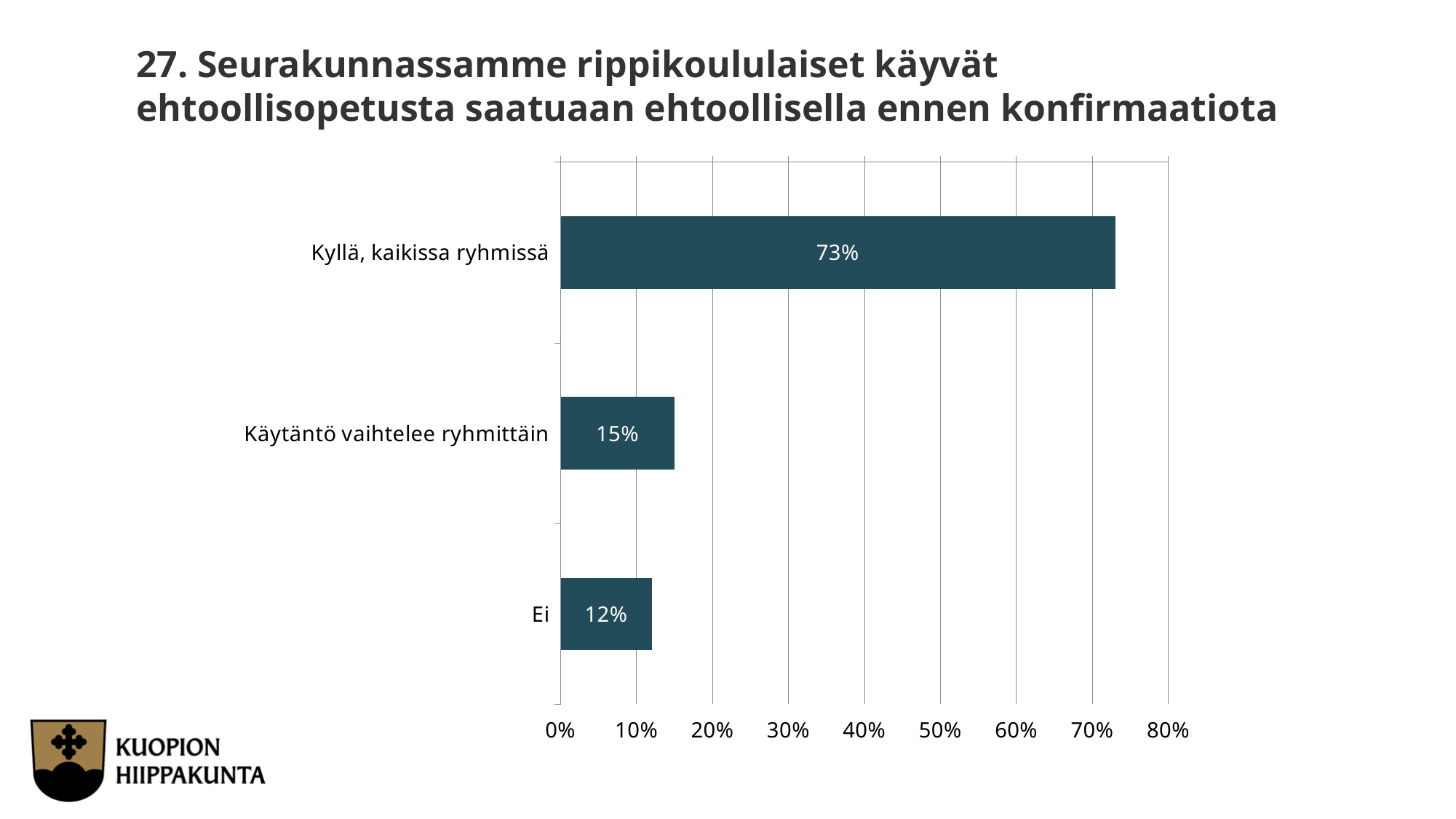
What is the maximum value shown on the horizontal axis? 80% What is the difference between the values for "Kyllä, kaikissa ryhmissä" and "Ei"? 61% How many categories are shown in the chart? 3 What is the value for "Kyllä, kaikissa ryhmissä"? 73% What is the difference between the values for "Käytäntö vaihtelee ryhmittäin" and "Ei"? 3% Which category has the lowest value? Ei Which is larger: the value for "Käytäntö vaihtelee ryhmittäin" or the value for "Ei"? Käytäntö vaihtelee ryhmittäin Which category has the highest value? Kyllä, kaikissa ryhmissä Is the value for "Kyllä, kaikissa ryhmissä" greater or less than 70%? greater What is the value for "Käytäntö vaihtelee ryhmittäin"? 15% What kind of chart is shown on the slide? Bar chart What is the value for "Ei"? 12%